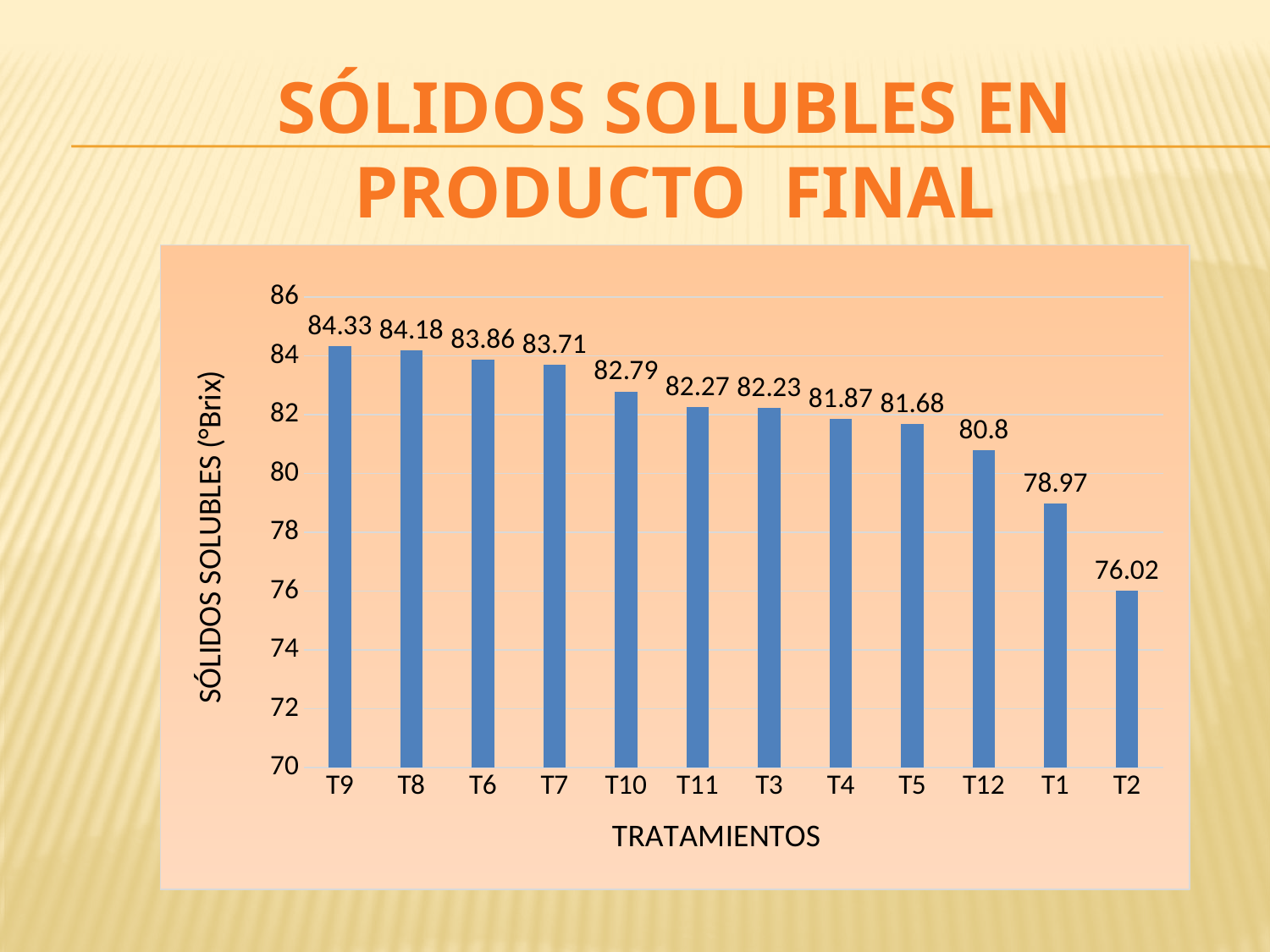
Which treatment has the lowest value? T2 What is the difference between the values for T9 and T2? 8.31 Which treatment has the highest value? T9 How many treatments are shown on the x axis? 12 What is the value for T1? 78.97 What is the difference between the values for T10 and T12? 1.99 What is the label of the y axis? SÓLIDOS SOLUBLES (°Brix) Which is larger, the value for T6 or the value for T5? T6 What is the value for T9? 84.33 What is the value for T12? 80.8 What kind of chart is this? bar chart Do the values rise or fall from left to right along the x axis? fall